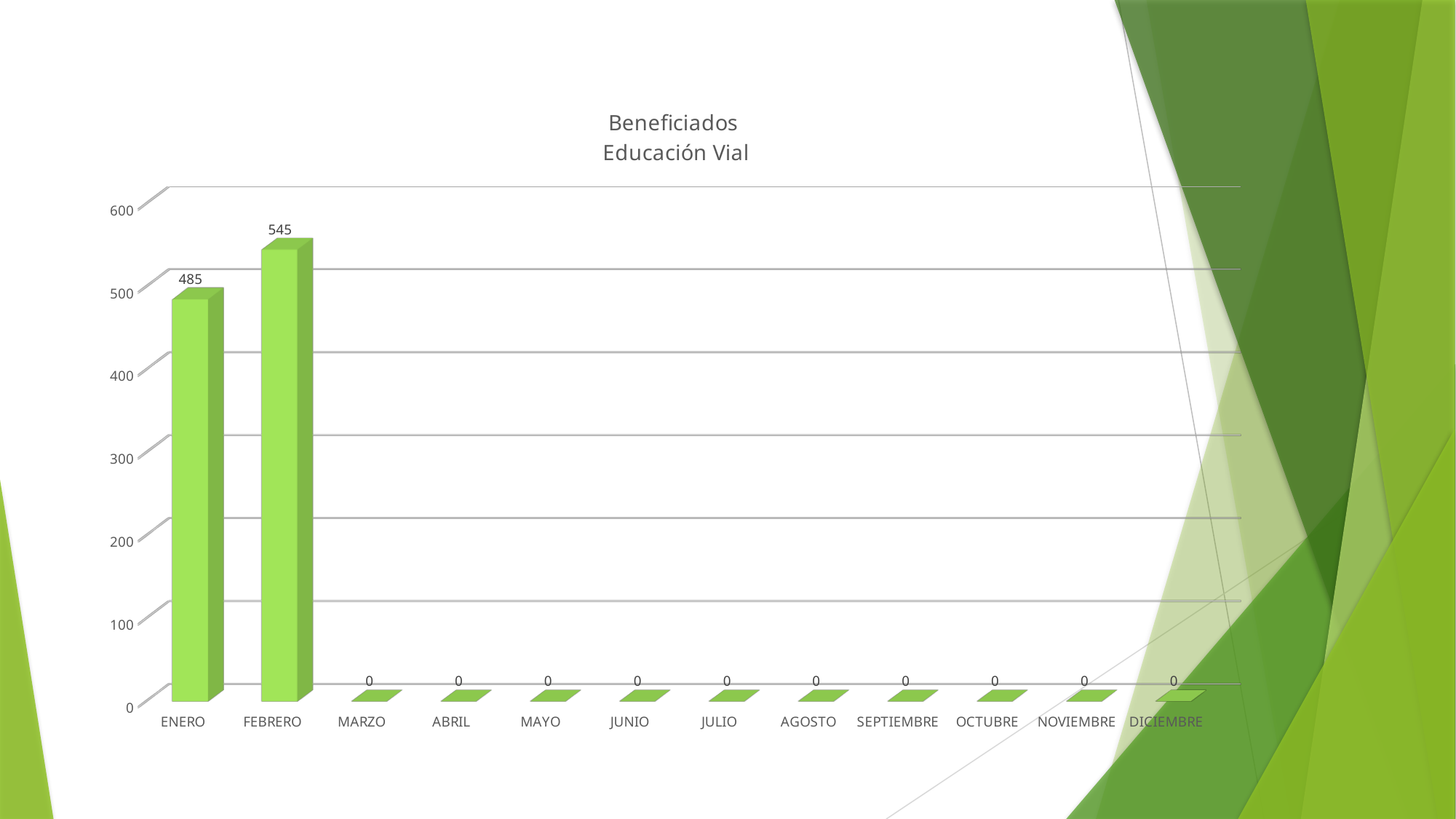
What is the value for ENERO? 485 What is the value for MARZO? 0 What is the value for FEBRERO? 545 What kind of chart is shown on the slide? bar chart What is the difference between the values for FEBRERO and ENERO? 60 Is the value for ENERO greater or less than 400? greater How many months are shown on the x axis? 12 Which is larger, the value for ENERO or the value for FEBRERO? FEBRERO What is the title of the chart? Beneficiados Educación Vial Which month has the highest value? FEBRERO How many months have a value of 0? 10 What is the highest value shown on the vertical axis? 600